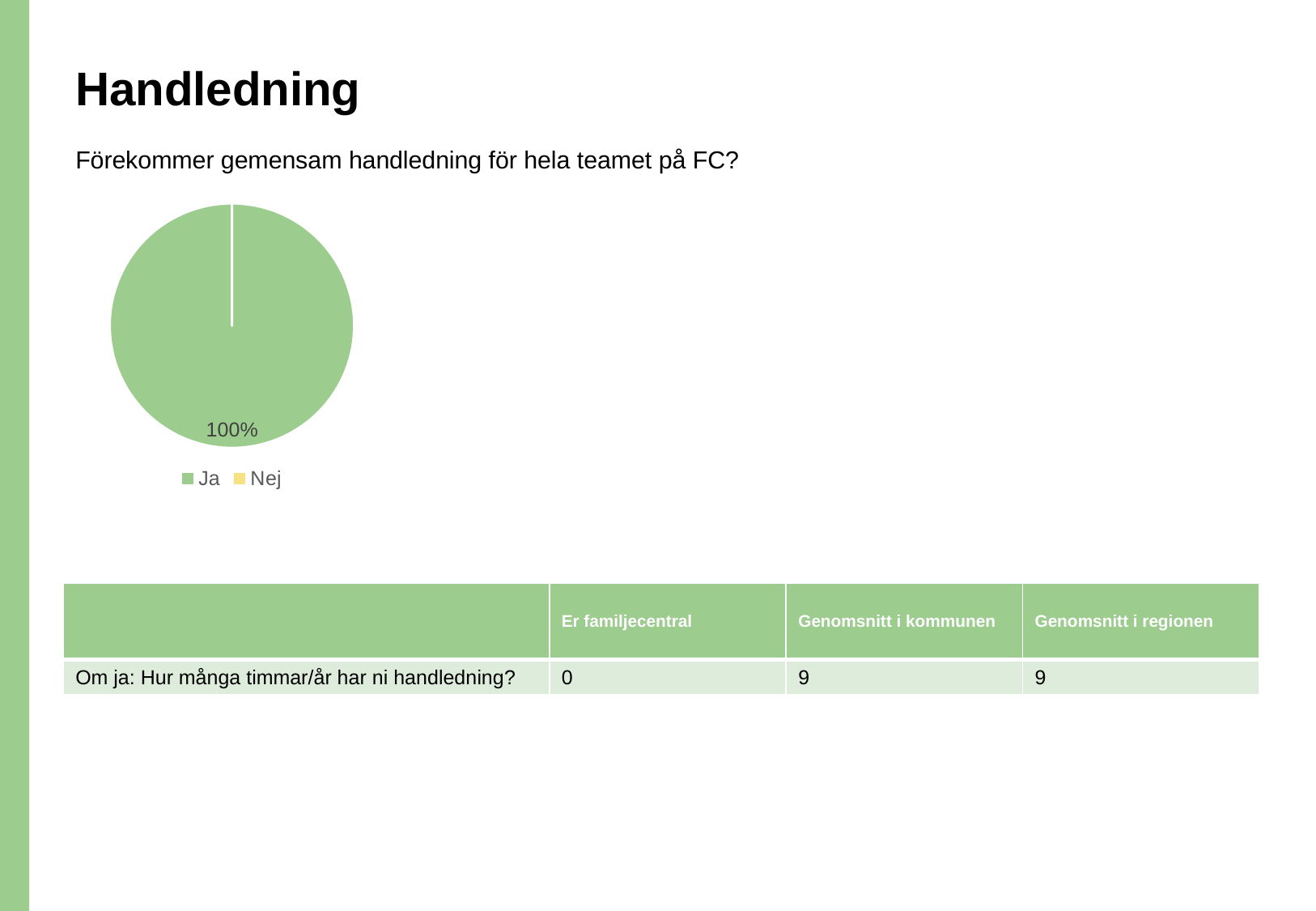
How many entries does the pie chart's legend list? 2 What are the two entries listed in the pie chart's legend? Ja and Nej What is the only percentage label printed on the pie chart? 100% What share of the pie chart does the Ja slice represent? 100% What kind of chart is shown on the slide? pie chart Which category has the largest share in the pie chart? Ja Which is larger in the pie chart, the share for Ja or the share for Nej? Ja What colour represents Ja in the pie chart? green